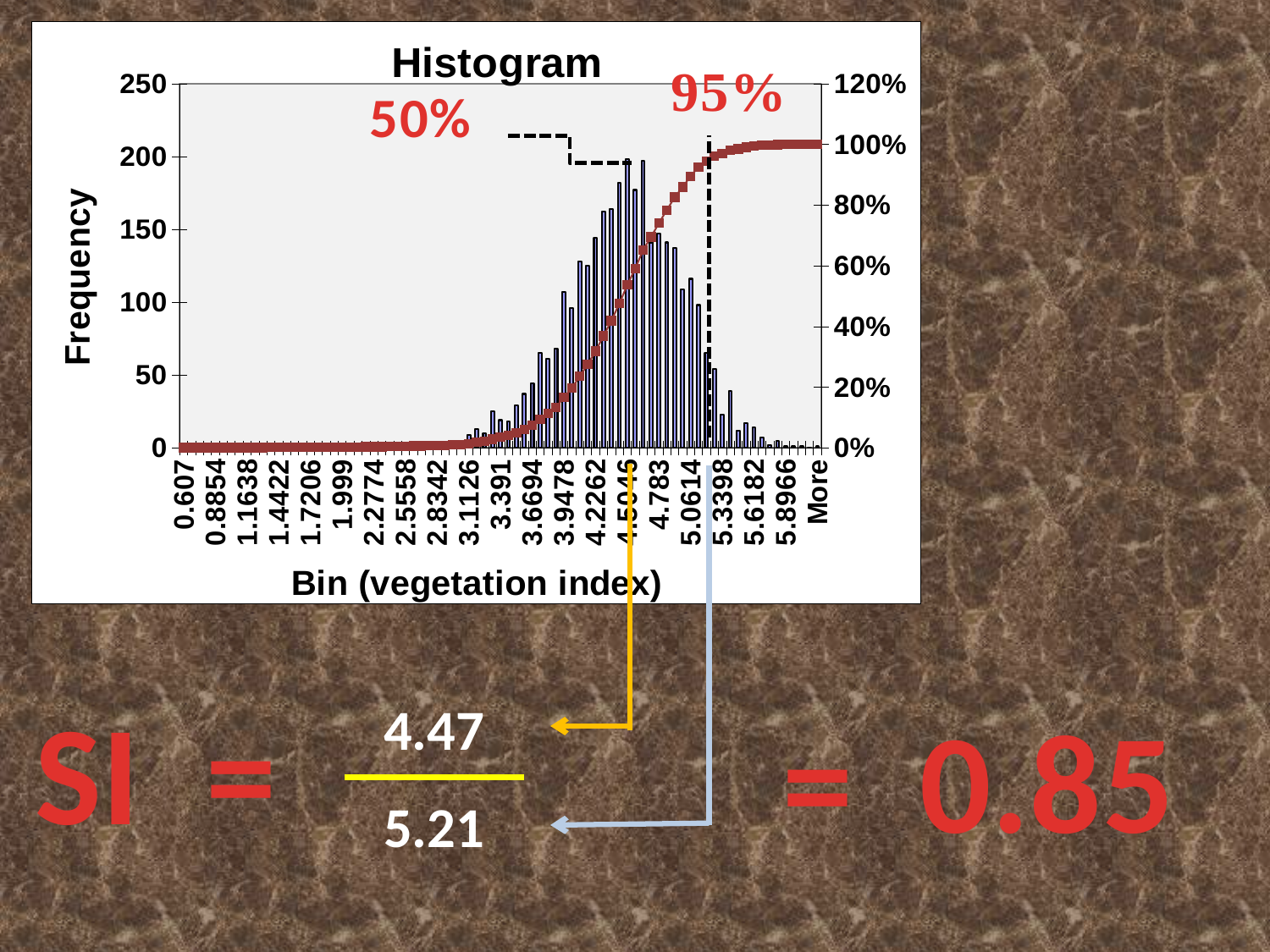
What is the label of the x axis of the chart? Bin (vegetation index) Does the cumulative percentage line rise or fall as the bin values increase along the x axis? rise What kind of chart is shown on the slide? bar chart with a cumulative line What vegetation index value is marked on the slide as corresponding to the 95% point of the cumulative curve? 5.21 What is the title of the chart? Histogram What vegetation index value is marked on the slide as corresponding to the 50% point of the cumulative curve? 4.47 Is the tallest bar in the histogram greater or less than 150 in frequency? greater Is the frequency for bin 3.391 greater or less than 50? less Is the frequency for bin 5.0614 greater or less than 50? greater What is the highest tick value shown on the left (Frequency) axis? 250 What is the highest tick value shown on the right percentage axis? 120%